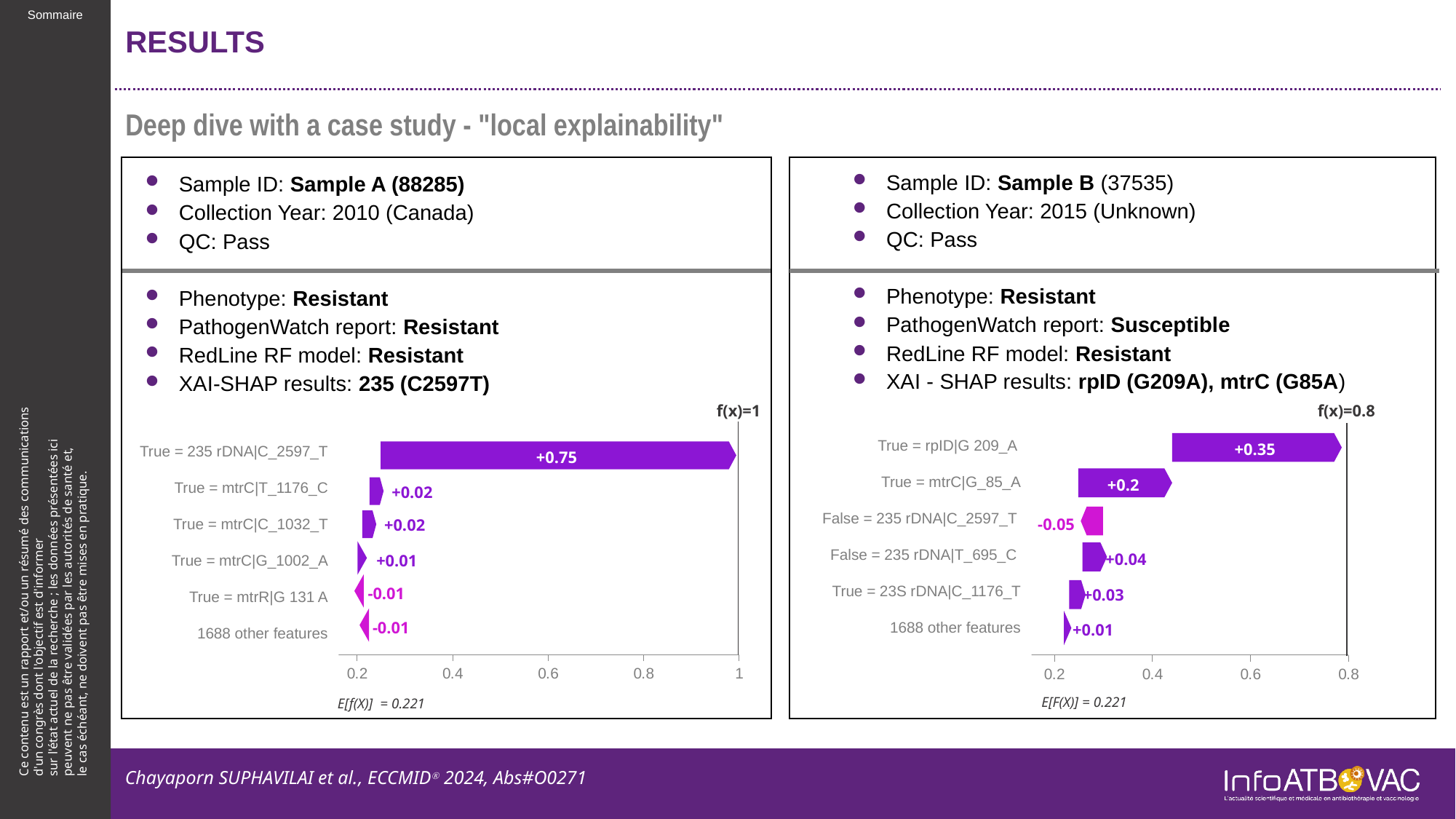
In the right chart (Sample B), which feature has the largest SHAP contribution? True = rpID|G 209_A In the right chart (Sample B), what is the SHAP value shown for 'False = 235 rDNA|C_2597_T'? -0.05 In the left chart (Sample A), which is larger: the SHAP value for 'True = 235 rDNA|C_2597_T' or for 'True = mtrC|T_1176_C'? True = 235 rDNA|C_2597_T What is the final model output f(x) shown at the top of the right chart (Sample B)? f(x)=0.8 What is the final model output f(x) shown at the top of the left chart (Sample A)? f(x)=1 In the left chart (Sample A), what is the SHAP value shown for 'True = 235 rDNA|C_2597_T'? +0.75 In the right chart (Sample B), what is the SHAP value shown for 'True = 23S rDNA|C_1176_T'? +0.03 In the right chart (Sample B), which feature has the lowest (most negative) SHAP value? False = 235 rDNA|C_2597_T In the right chart (Sample B), what is the SHAP value shown for 'True = rpID|G 209_A'? +0.35 In the right chart (Sample B), what is the difference between the SHAP values for 'True = rpID|G 209_A' and 'True = mtrC|G_85_A'? 0.15 In the left chart (Sample A), what is the SHAP value shown for '1688 other features'? -0.01 How many feature rows are plotted in the left chart (Sample A)? 6